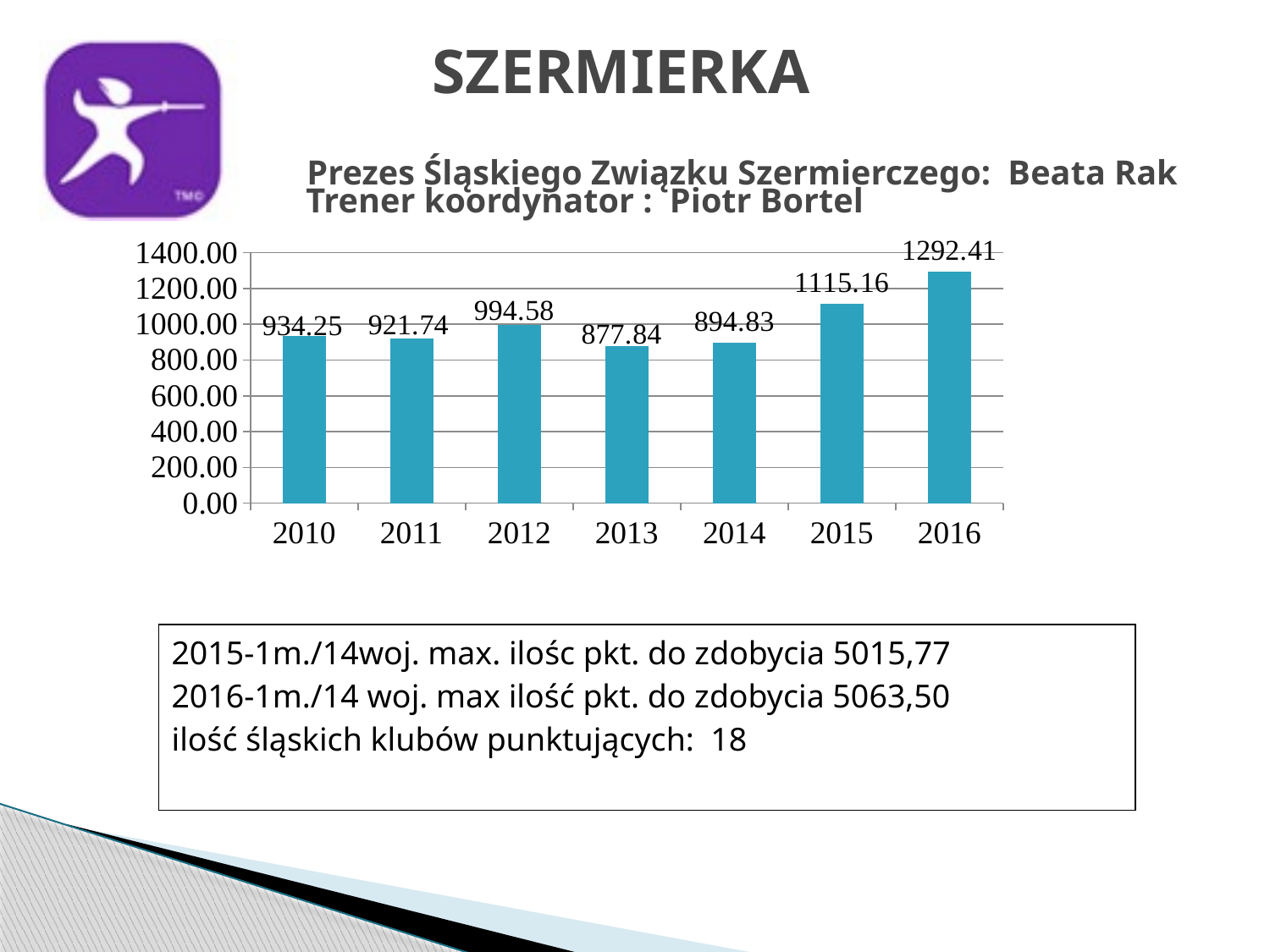
What is the value shown for 2015? 1115.16 What is the difference between the values for 2012 and 2013? 116.74 Which is larger, the value for 2012 or the value for 2014? 2012 How many years are shown on the x axis? 7 Is the value for 2015 greater or less than 1000.00? greater Do the values rise or fall from 2014 to 2016? rise What is the value shown for 2010? 934.25 What is the value shown for 2013? 877.84 Which year has the highest value? 2016 What kind of chart is shown on the slide? bar chart Which year has the lowest value? 2013 What is the difference between the values for 2016 and 2015? 177.25